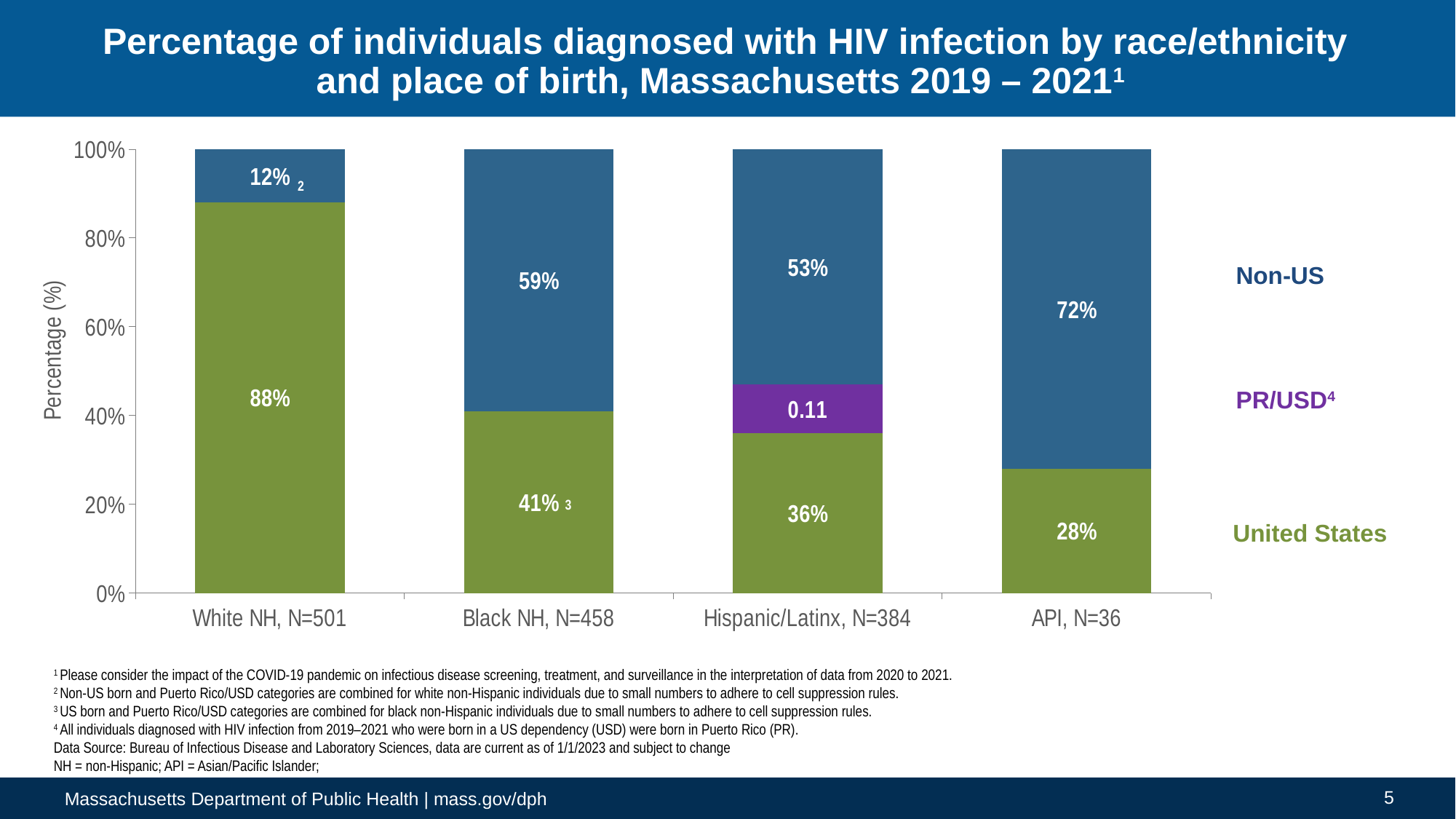
Which is larger: the Non-US percentage for Black NH or for Hispanic/Latinx? Black NH How many series does the legend list? 3 Which race/ethnicity group has the lowest United States percentage? API, N=36 What kind of chart is shown on the slide? Stacked bar chart How many race/ethnicity categories are shown on the x axis? 4 Which race/ethnicity group has the highest Non-US percentage? API, N=36 What is the Non-US value for Black NH, N=458? 59% What is the difference between the United States percentages for White NH and Black NH? 47% What value is printed on the PR/USD segment for Hispanic/Latinx, N=384? 0.11 What is the label of the y axis? Percentage (%) What is the Non-US percentage for API, N=36? 72% What percentage of White NH individuals diagnosed with HIV infection were born in the United States? 88%